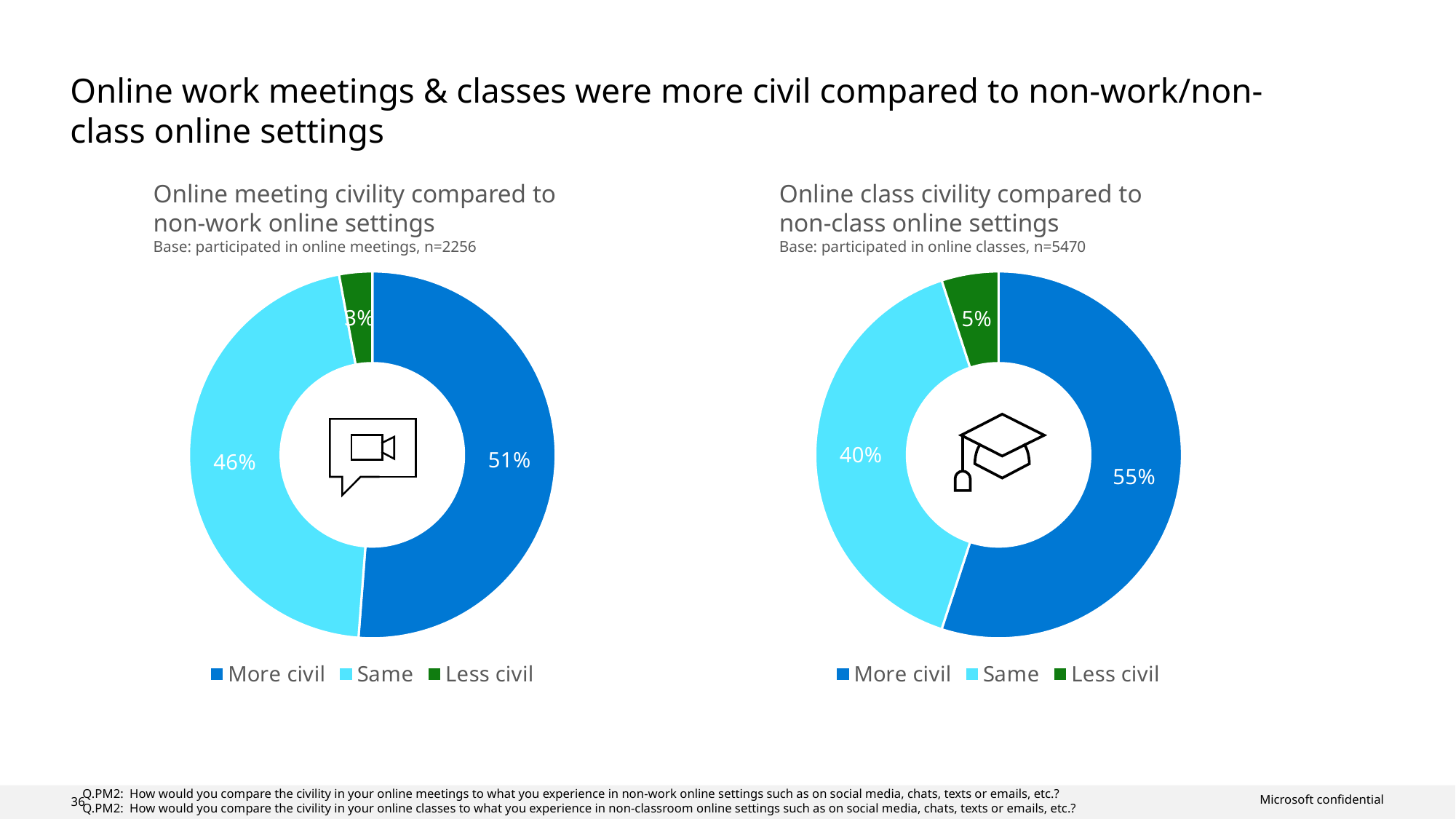
In the 'Online class civility compared to non-class online settings' chart, what percentage said 'Same'? 40% In the 'Online meeting civility compared to non-work online settings' chart, what percentage said 'More civil'? 51% How many categories does the legend of the 'Online meeting civility compared to non-work online settings' chart list? 3 In the 'Online meeting civility compared to non-work online settings' chart, what percentage said 'Same'? 46% In the 'Online class civility compared to non-class online settings' chart, what is the difference between the 'More civil' and 'Same' shares? 15% What is the base size stated for the 'Online class civility compared to non-class online settings' chart? n=5470 Which chart has a larger 'More civil' share: the online meeting chart or the online class chart? The online class chart In the 'Online meeting civility compared to non-work online settings' chart, what colour represents 'Less civil'? Green In the 'Online class civility compared to non-class online settings' chart, which category has the largest share? More civil In the 'Online class civility compared to non-class online settings' chart, what percentage said 'Less civil'? 5% In the 'Online meeting civility compared to non-work online settings' chart, which category has the smallest share? Less civil What kind of chart is the 'Online class civility compared to non-class online settings' chart? Doughnut chart